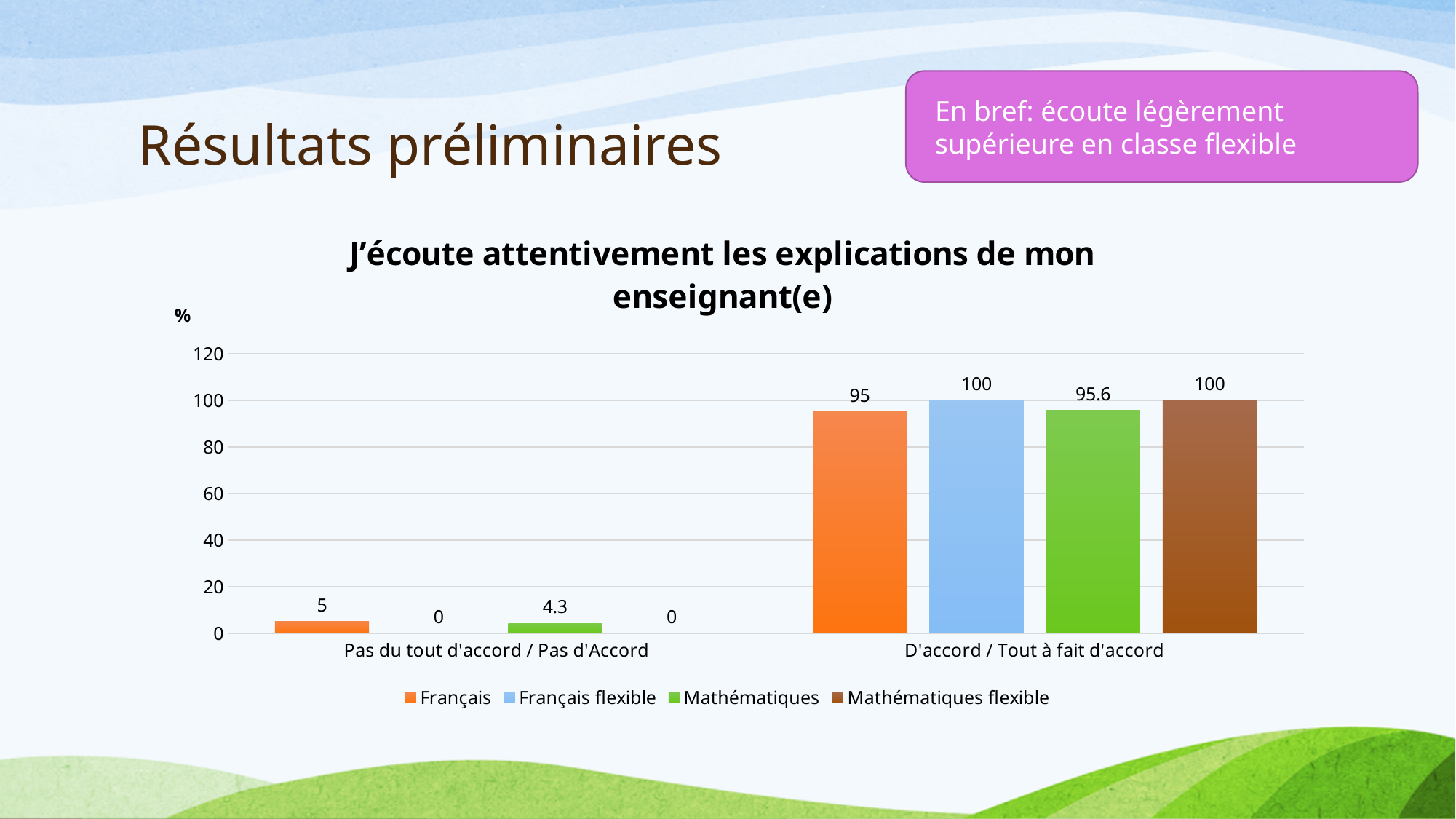
How many series does the legend list? 4 How many categories are shown on the x axis? 2 What is the value for Mathématiques in the "D'accord / Tout à fait d'accord" category? 95.6 What is the value for Français in the "Pas du tout d'accord / Pas d'Accord" category? 5 What kind of chart is shown on the slide? Bar chart What is the title of the chart? J'écoute attentivement les explications de mon enseignant(e) Which series has the lowest value in the "D'accord / Tout à fait d'accord" category? Français What is the difference between the Français flexible and Français values in the "D'accord / Tout à fait d'accord" category? 5 What is the value for Mathématiques in the "Pas du tout d'accord / Pas d'Accord" category? 4.3 In the "Pas du tout d'accord / Pas d'Accord" category, which is larger: Français or Mathématiques? Français What is the value for Français flexible in the "D'accord / Tout à fait d'accord" category? 100 What is the value for Mathématiques flexible in the "Pas du tout d'accord / Pas d'Accord" category? 0